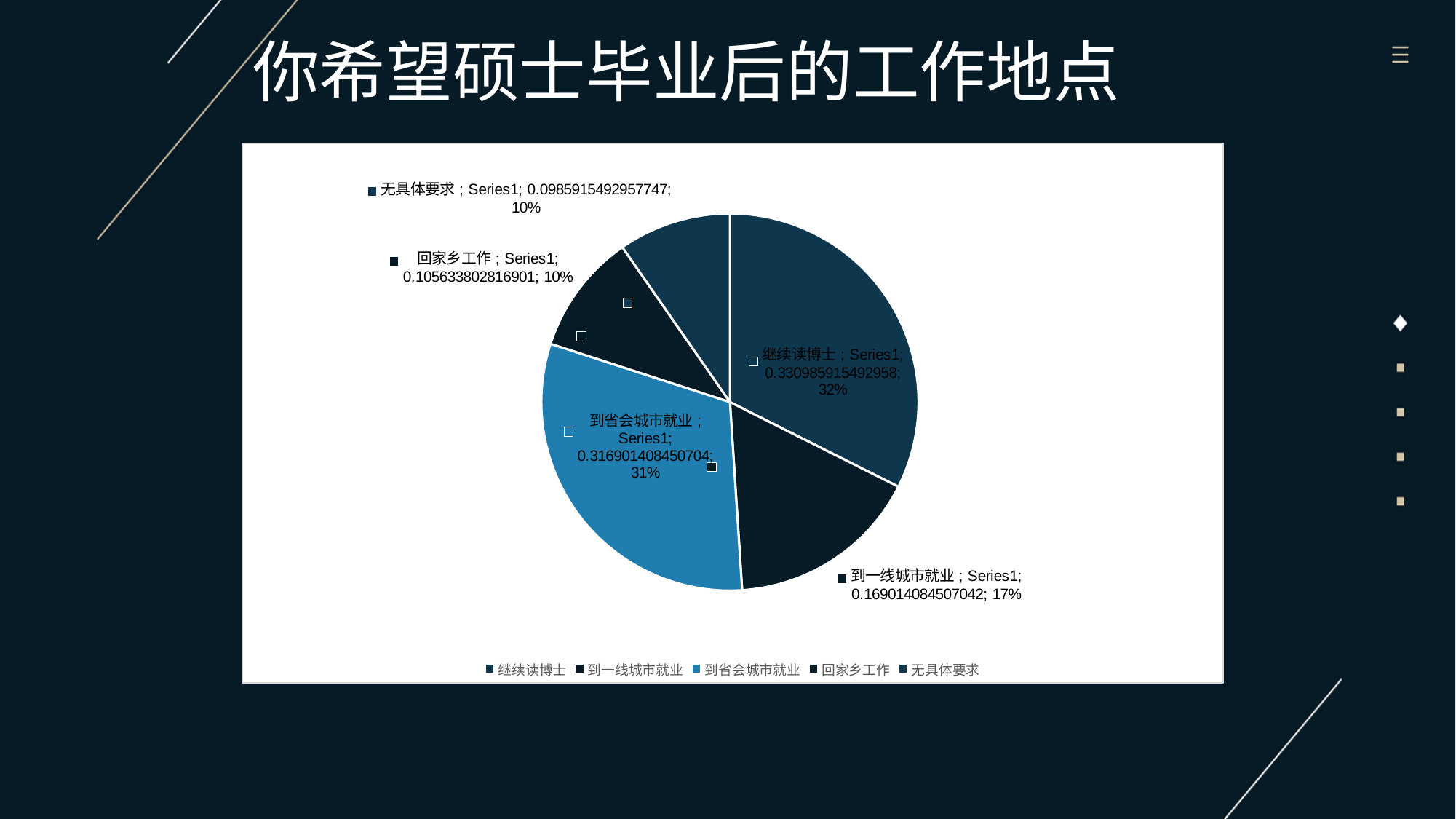
What is the difference in percentage points between the 继续读博士 share and the 到一线城市就业 share? 15 percentage points What percentage share does the 回家乡工作 slice have? 10% Which is larger, the share for 到一线城市就业 or the share for 到省会城市就业? 到省会城市就业 What kind of chart is shown on the slide? pie chart What percentage share does the 继续读博士 slice have? 32% What percentage share does the 到一线城市就业 slice have? 17% What is the title of the slide containing the pie chart? 你希望硕士毕业后的工作地点 Which category is listed first in the legend below the pie chart? 继续读博士 What is the raw value printed for the 无具体要求 slice? 0.0985915492957747 How many slices does the pie chart have? 5 Which category has the largest share of the pie? 继续读博士